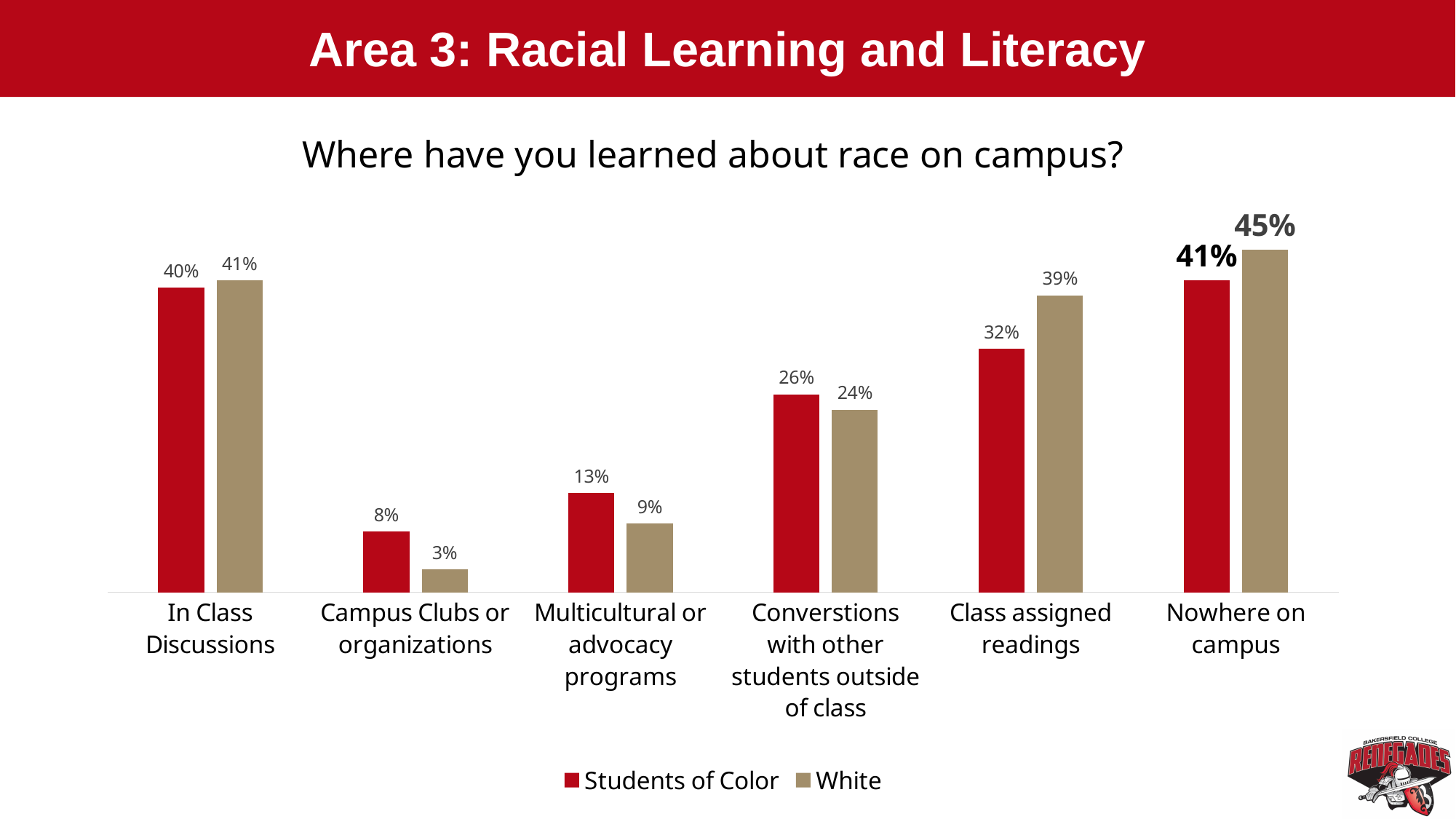
How many categories are shown on the x axis? 6 For Multicultural or advocacy programs, which series has the larger value, Students of Color or White? Students of Color What is the value for Students of Color for In Class Discussions? 40% What kind of chart is shown on the slide? Bar chart What is the value for White students for Nowhere on campus? 45% How many series does the legend list? 2 What is the title of the chart? Where have you learned about race on campus? What is the value for Students of Color for Class assigned readings? 32% What is the value for White students for Campus Clubs or organizations? 3% Which category has the lowest value for Students of Color? Campus Clubs or organizations Which category has the highest value for White students? Nowhere on campus What is the difference between the White and Students of Color values for Class assigned readings? 7%